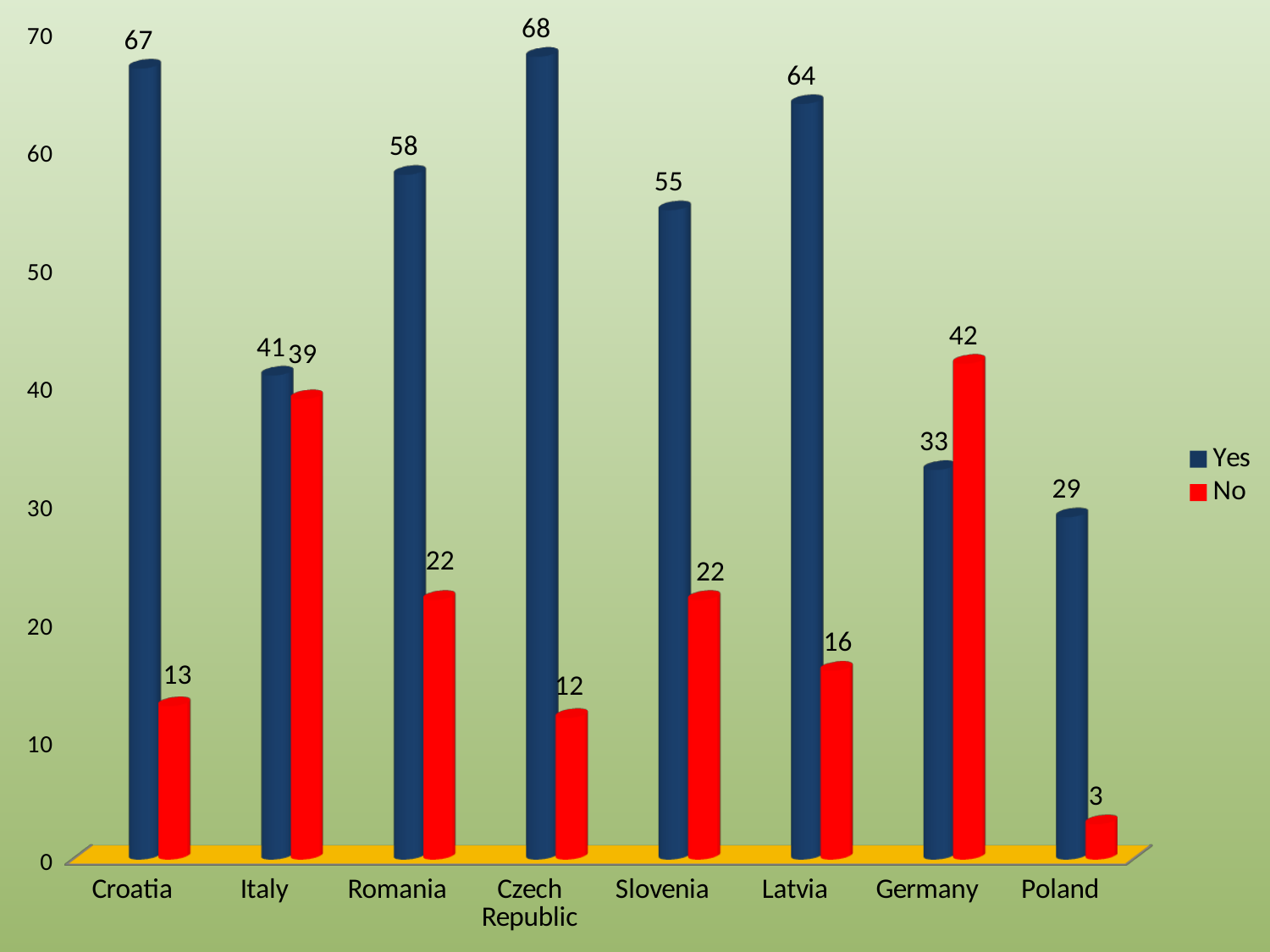
Which is larger for Germany, the Yes value or the No value? No What is the difference between the Yes values for Latvia and Germany? 31 What is the Yes value for Croatia? 67 What colour are the No bars? Red How many series does the legend list? 2 What is the No value for Germany? 42 What kind of chart is shown on the slide? Bar chart Which country has the lowest No value? Poland Which country has the highest Yes value? Czech Republic What is the difference between the Yes and No values for Italy? 2 What is the No value for Poland? 3 How many countries are shown on the x axis? 8